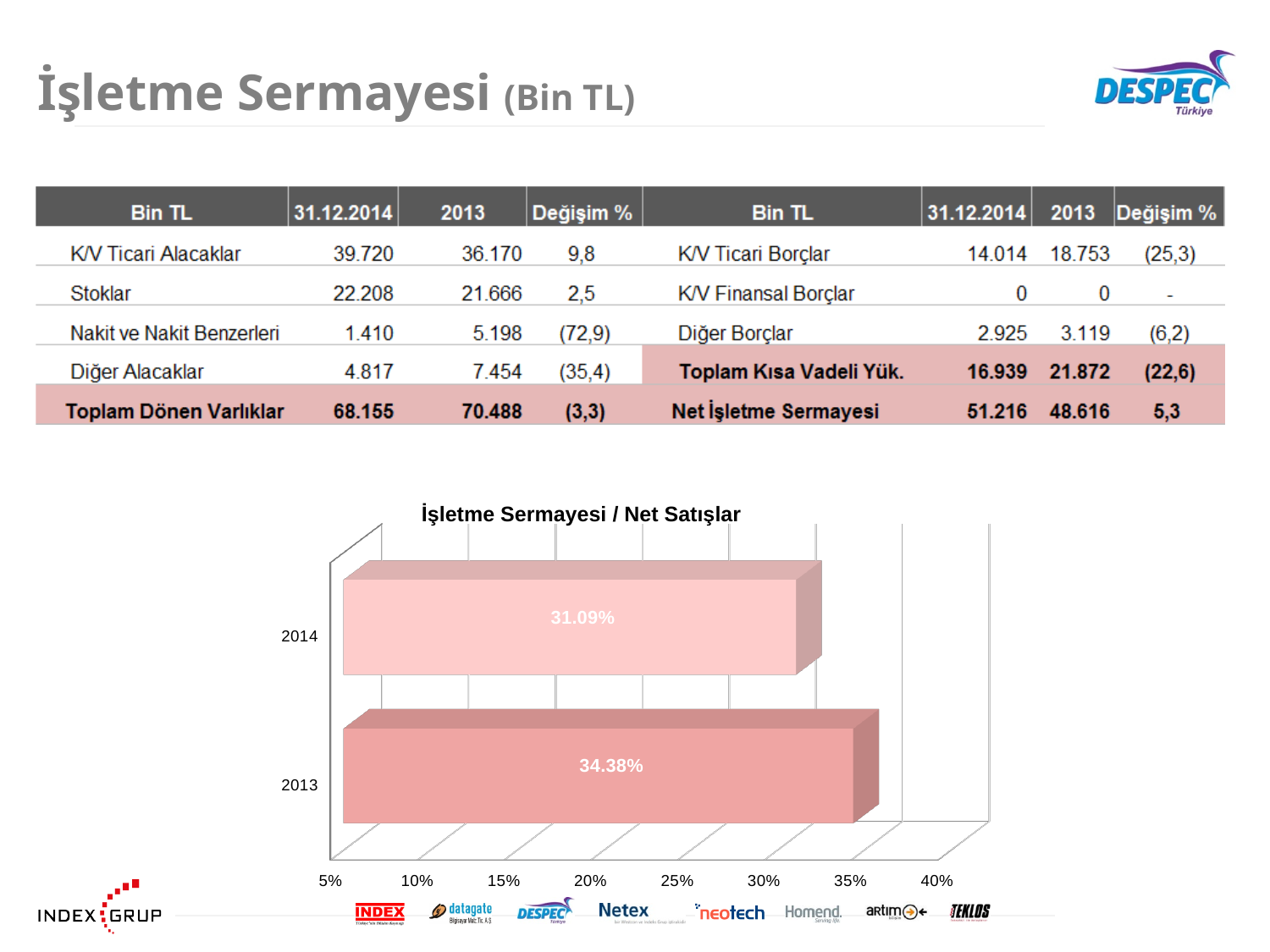
Is the value for 2014 greater or less than 35% in the İşletme Sermayesi / Net Satışlar chart? less What kind of chart is the İşletme Sermayesi / Net Satışlar chart? bar chart Is the value for 2014 larger or smaller than the value for 2013 in the İşletme Sermayesi / Net Satışlar chart? smaller Which year has the lower value in the İşletme Sermayesi / Net Satışlar chart? 2014 Did the İşletme Sermayesi / Net Satışlar ratio rise or fall from 2013 to 2014? fall What is the title of the chart on the slide? İşletme Sermayesi / Net Satışlar What is the value for 2014 in the İşletme Sermayesi / Net Satışlar chart? 31.09% Is the value for 2013 greater or less than 30% in the İşletme Sermayesi / Net Satışlar chart? greater What is the difference between the 2013 and 2014 values in the İşletme Sermayesi / Net Satışlar chart? 3.29% What is the value for 2013 in the İşletme Sermayesi / Net Satışlar chart? 34.38% How many bars are shown in the İşletme Sermayesi / Net Satışlar chart? 2 Which year has the higher value in the İşletme Sermayesi / Net Satışlar chart? 2013